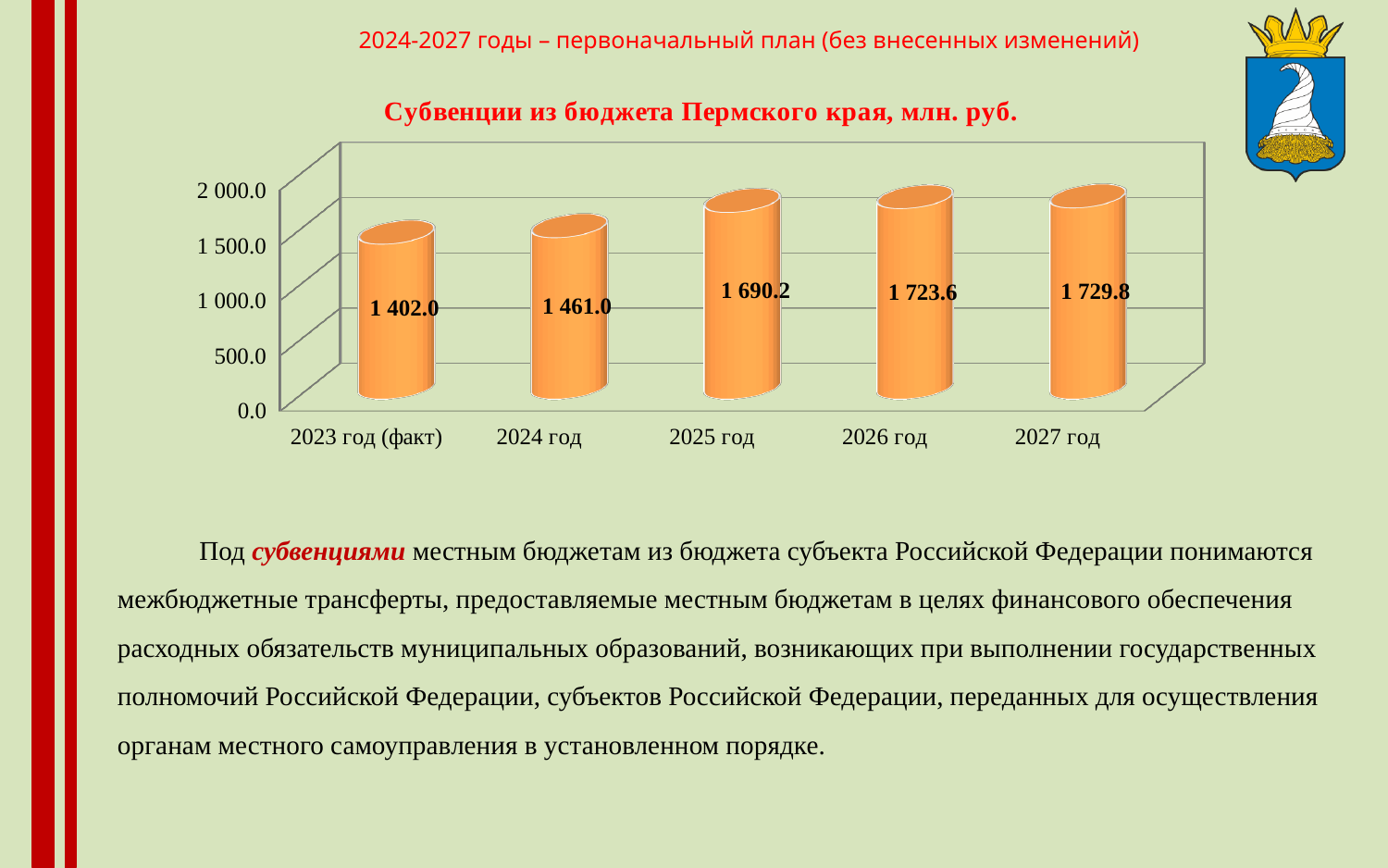
Which category has the lowest value in the chart? 2023 год (факт) What kind of chart is shown on the slide? bar chart What is the value for 2027 год in the chart? 1 729.8 What is the difference between the values for 2024 год and 2023 год (факт)? 59.0 How many categories are shown on the x axis of the chart? 5 Do the values rise or fall from 2023 год (факт) to 2027 год? rise Which is larger, the value for 2025 год or the value for 2024 год? 2025 год Is the value for 2026 год greater or less than 1 500.0? greater Which year has the highest value in the chart? 2027 год What is the value for 2023 год (факт) in the chart 'Субвенции из бюджета Пермского края, млн. руб.'? 1 402.0 What is the value for 2025 год in the chart? 1 690.2 What is the difference between the values for 2027 год and 2026 год? 6.2